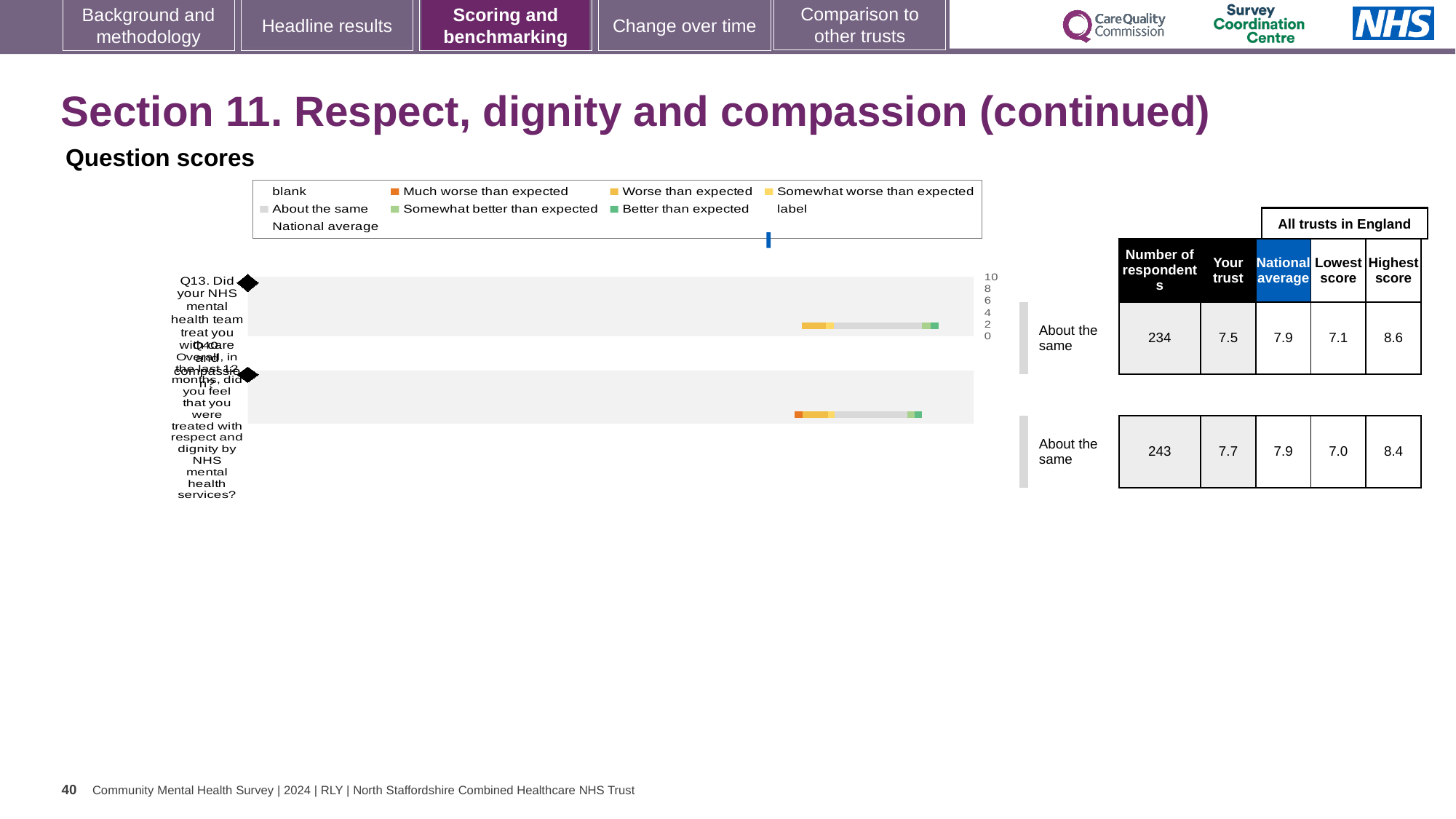
What kind of chart is shown on the slide? bar chart What is the 'Your trust' score for Q14? 7.7 Which question has the higher 'Your trust' score, Q13 or Q14? Q14 What is the national average score for Q13? 7.9 What benchmarking category is shown for Q13 and Q14? About the same How many questions (categories) are plotted in the chart? 2 What is the difference between the national average and the 'Your trust' score for Q13? 0.4 What is the difference between the highest scores for Q13 and Q14? 0.2 What is the lowest score among all trusts in England for Q14? 7.0 What is the number of respondents for Q14? 243 What is the 'Your trust' score for Q13? 7.5 What is the highest score among all trusts in England for Q13? 8.6